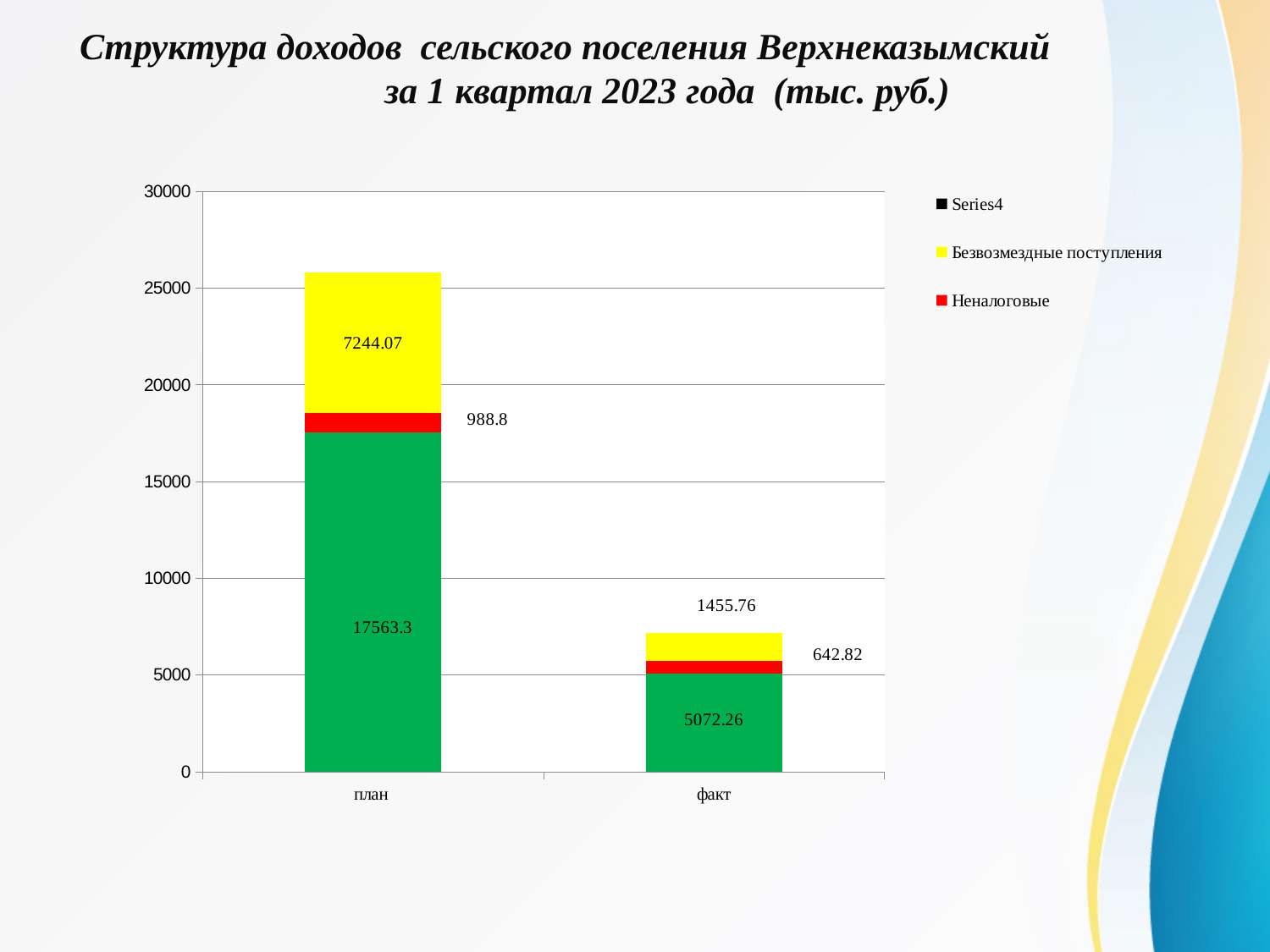
Which category has the taller stacked bar, план or факт? план Is the total of the план bar greater or less than 25000? greater What is the total of the stacked bar for факт? 7170.84 What is the value of Безвозмездные поступления for факт? 1455.76 What is the difference between Неналоговые for план and for факт? 345.98 What is the value of Неналоговые for план? 988.8 What is the difference between Безвозмездные поступления for план and for факт? 5788.31 What is the value of Безвозмездные поступления for план? 7244.07 What is the value of the green segment for план? 17563.3 What is the value of Неналоговые for факт? 642.82 How many entries does the legend list? 3 How many categories are shown on the x axis? 2